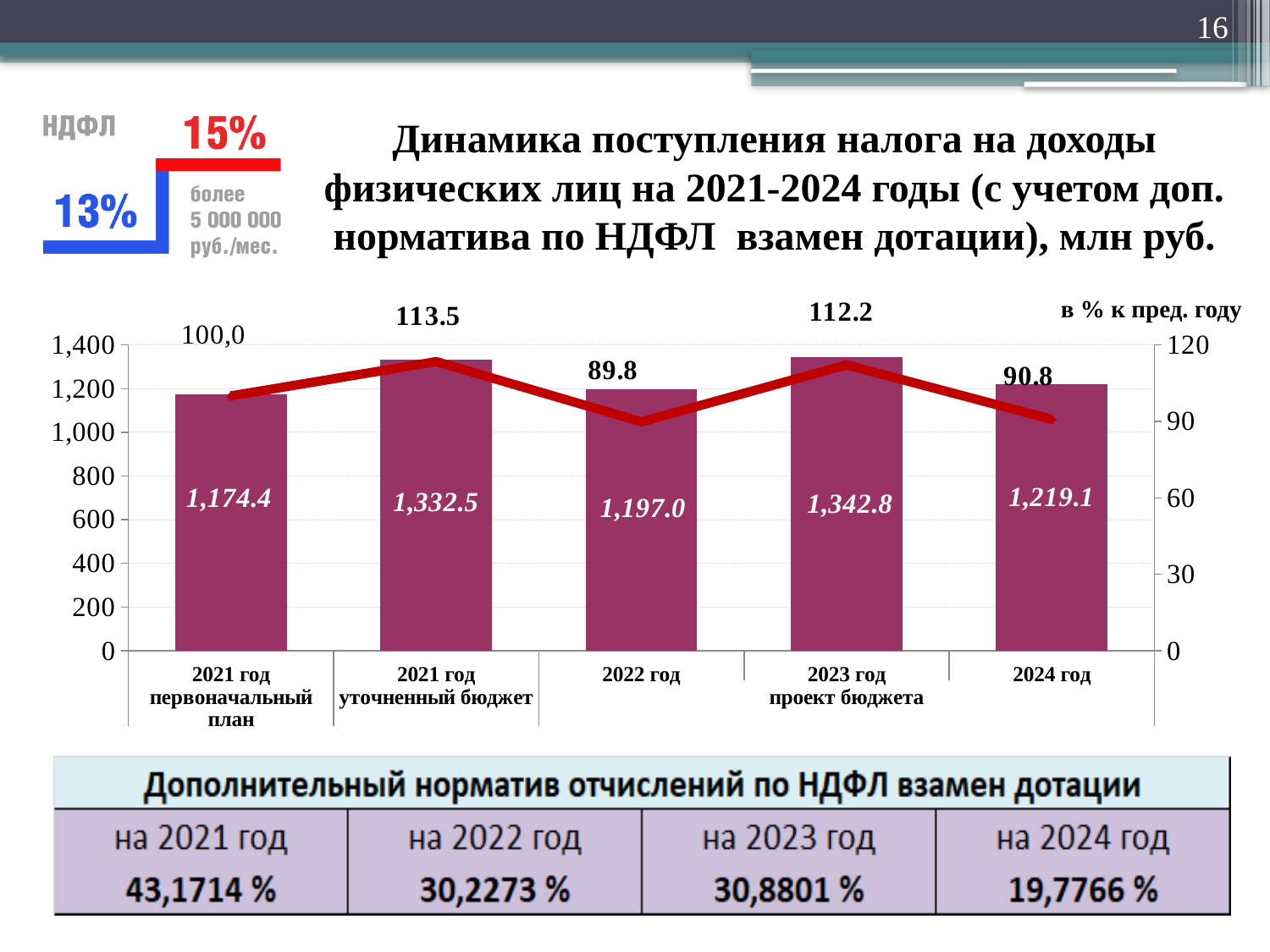
What is the bar value for 2021 год уточненный бюджет? 1,332.5 Which category has the highest bar value? 2023 год проект бюджета What is the lowest line value (в % к пред. году) shown on the chart? 89.8 Which is larger, the bar value for 2022 год or for 2024 год? 2024 год What is the difference between the bar values for 2023 год проект бюджета and 2024 год? 123.7 Which category has the lowest bar value? 2021 год первоначальный план Is the bar value for 2021 год первоначальный план greater or less than 1,200? less How many categories are shown on the x axis? 5 What is the bar value for 2022 год? 1,197.0 What is the line value (в % к пред. году) for 2024 год? 90.8 What kind of chart is this? Combined bar and line chart What is the line value (в % к пред. году) for 2023 год проект бюджета? 112.2